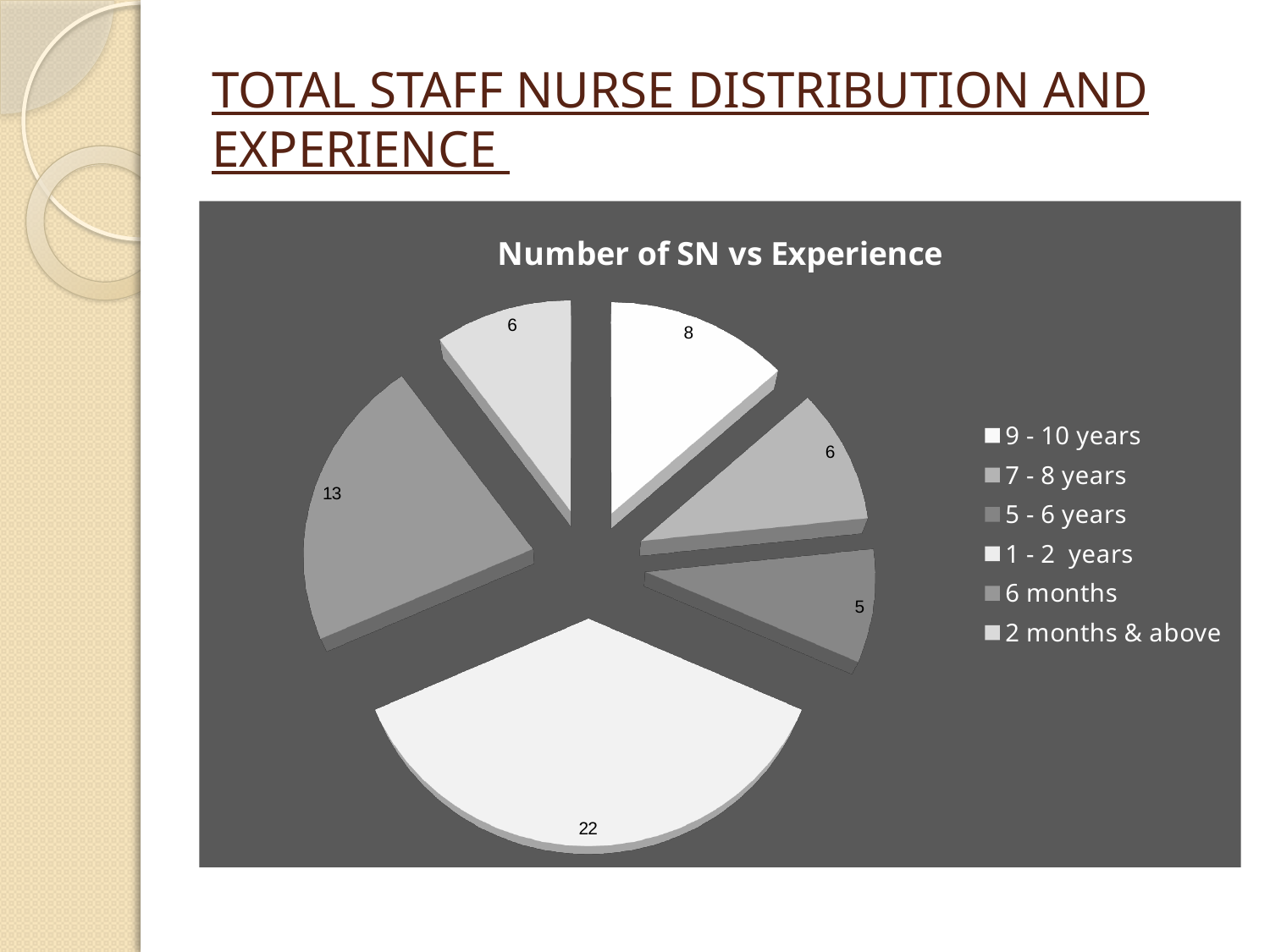
What is the value for the 9 - 10 years slice? 8 Which experience category has the smallest slice? 5 - 6 years What kind of chart is shown on the slide? Pie chart What is the value for the 5 - 6 years slice? 5 What is the value for the 1 - 2 years slice? 22 Which is larger, the 9 - 10 years slice or the 5 - 6 years slice? 9 - 10 years How many slices does the pie chart have? 6 What is the difference between the 1 - 2 years slice and the 6 months slice? 9 How many entries does the legend list? 6 What is the value for the 6 months slice? 13 What is the title of the chart? Number of SN vs Experience Which experience category has the largest slice? 1 - 2 years